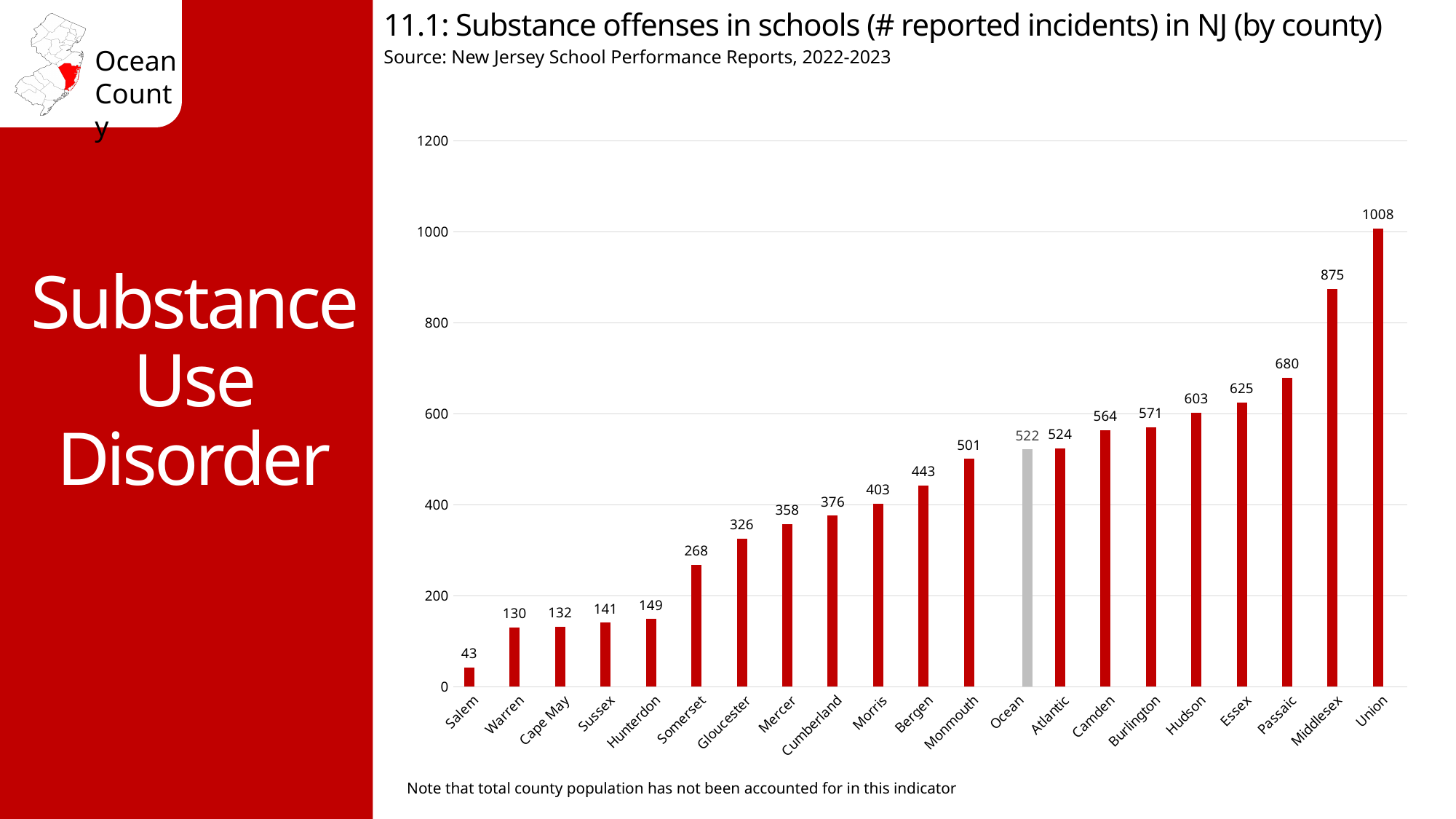
What is the difference between the values for Union and Middlesex? 133 Which county has the highest number of reported incidents? Union What kind of chart is shown on the slide? Bar chart Is the value for Passaic greater or less than 600? greater Which county's bar is coloured grey instead of red? Ocean What is the number of reported substance offense incidents in schools for Ocean County? 522 What is the source cited for the chart data? New Jersey School Performance Reports, 2022-2023 What is the value shown for Middlesex County? 875 Do the values rise or fall moving from left to right along the x axis? Rise How many counties are shown on the x axis of the chart? 21 Which county has more reported incidents, Camden or Bergen? Camden Which county has the lowest number of reported incidents? Salem